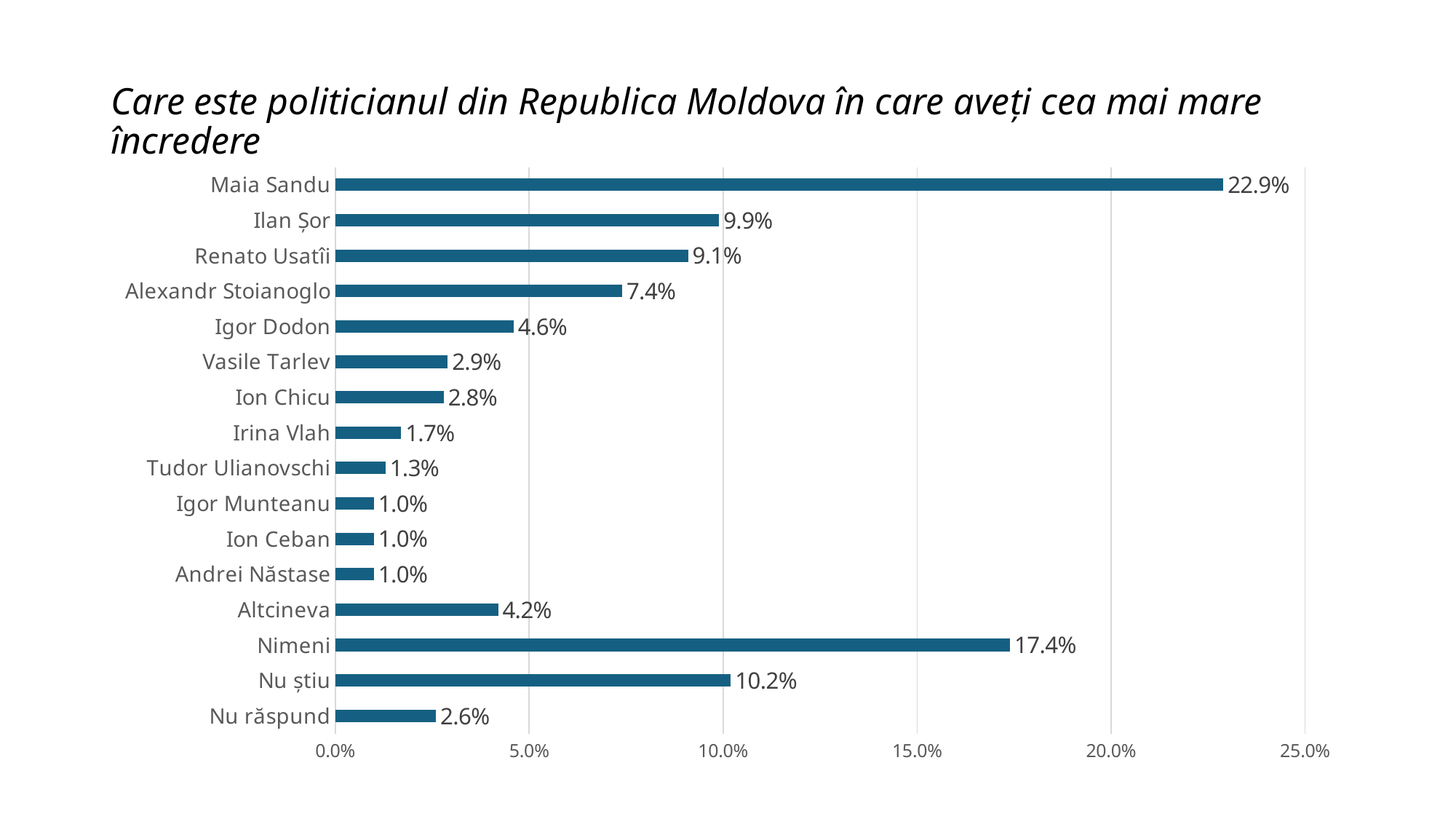
Which is larger, the value for Ilan Șor or the value for Nu știu? Nu știu What is the difference between the values for Renato Usatîi and Igor Dodon? 4.5% What is the value for Maia Sandu? 22.9% Which named politician has the lowest value, excluding the three tied at 1.0%? Tudor Ulianovschi What is the value for Alexandr Stoianoglo? 7.4% Is the value for Igor Dodon greater or less than 5.0%? less What is the value for Nimeni? 17.4% What is the maximum value shown on the x axis? 25.0% Which category has the highest value? Maia Sandu What is the difference between the values for Maia Sandu and Nimeni? 5.5% How many categories are shown on the chart? 16 What kind of chart is shown on the slide? Bar chart